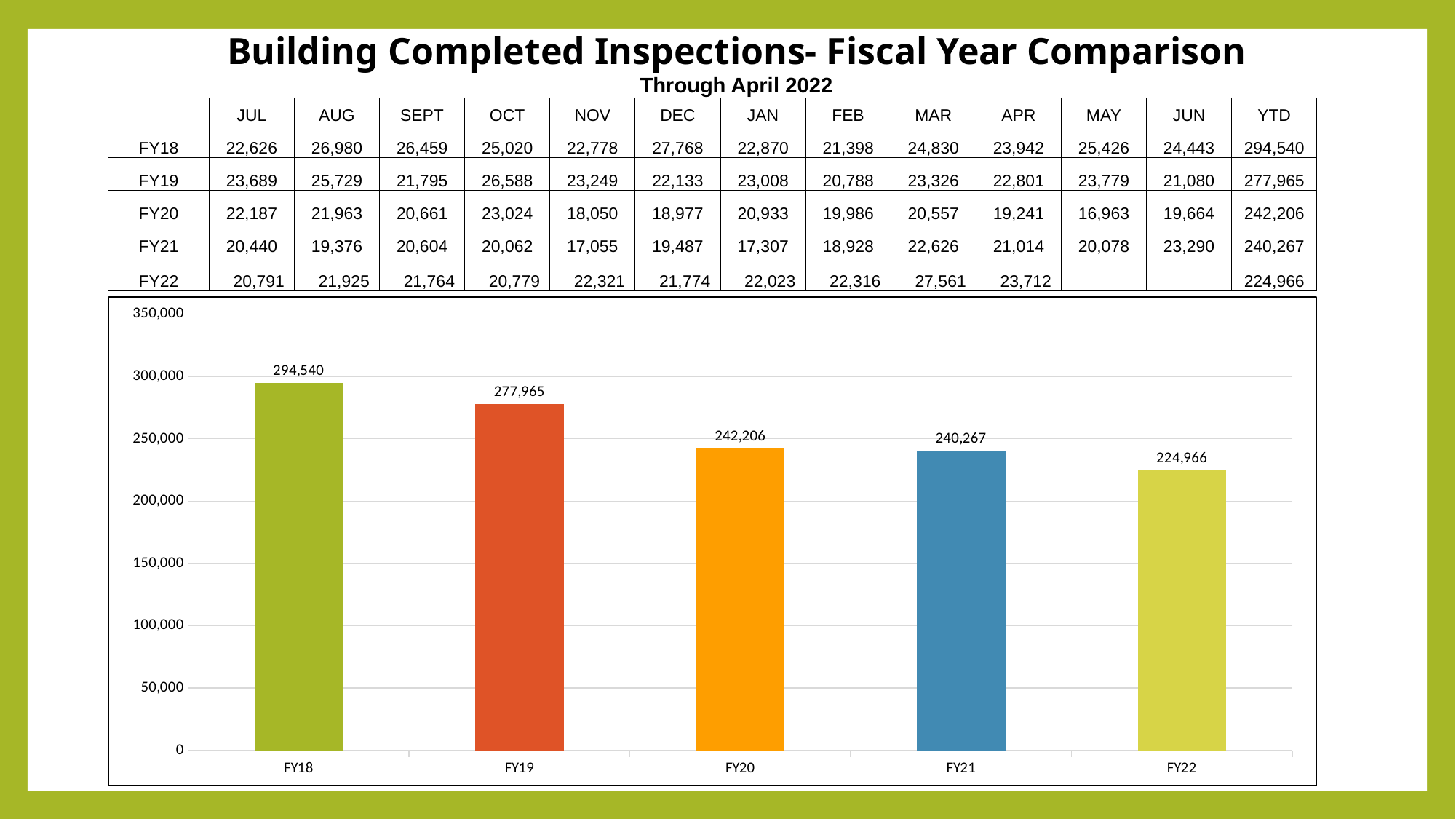
What kind of chart is shown on the slide? bar chart Which is larger, the bar for FY19 or the bar for FY21? FY19 What colour is the bar for FY21? blue What is the value of the bar for FY22? 224,966 What is the value of the bar for FY20? 242,206 Which fiscal year has the lowest bar? FY22 What is the difference between the FY18 and FY19 bars? 16,575 Which fiscal year has the highest bar? FY18 What is the value of the bar for FY18? 294,540 How many bars are shown in the chart? 5 What is the difference between the FY20 and FY21 bars? 1,939 Is the value for FY22 greater or less than 250,000? less